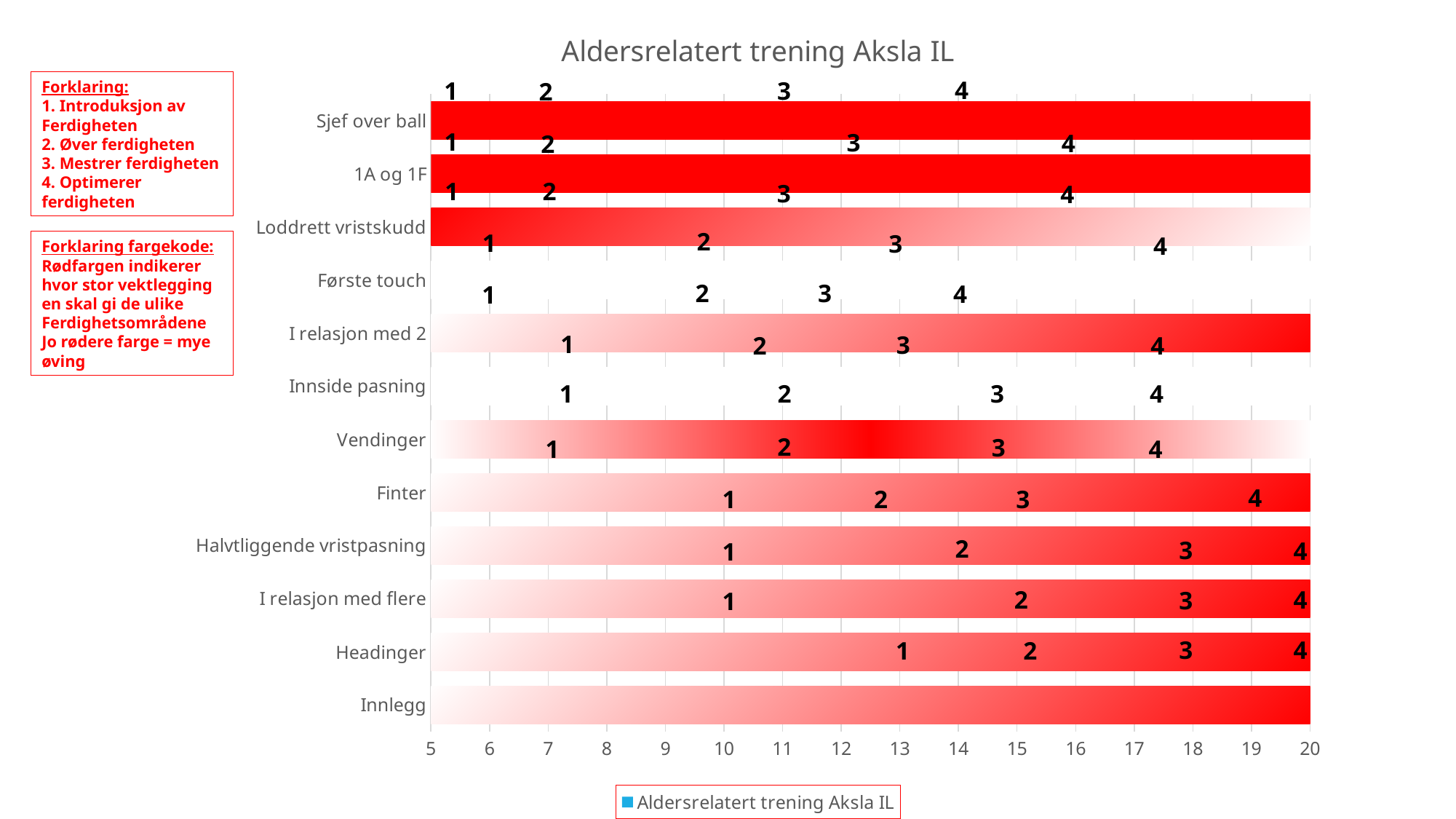
Is the age at which stage 1 is marked for Halvtliggende vristpasning greater or less than 8? greater Is the age at which stage 1 is marked for Headinger greater or less than 10? greater How many series does the chart legend list? 1 What kind of chart is shown on the slide? bar chart What is the lowest value shown on the horizontal axis of the chart? 5 Is the age at which stage 4 is marked for Headinger greater or less than 15? greater What is the title of the chart? Aldersrelatert trening Aksla IL How many skill categories are listed on the vertical axis of the chart? 12 What is the highest value shown on the horizontal axis of the chart? 20 Which category has stage 4 marked at a later age: Sjef over ball or Headinger? Headinger